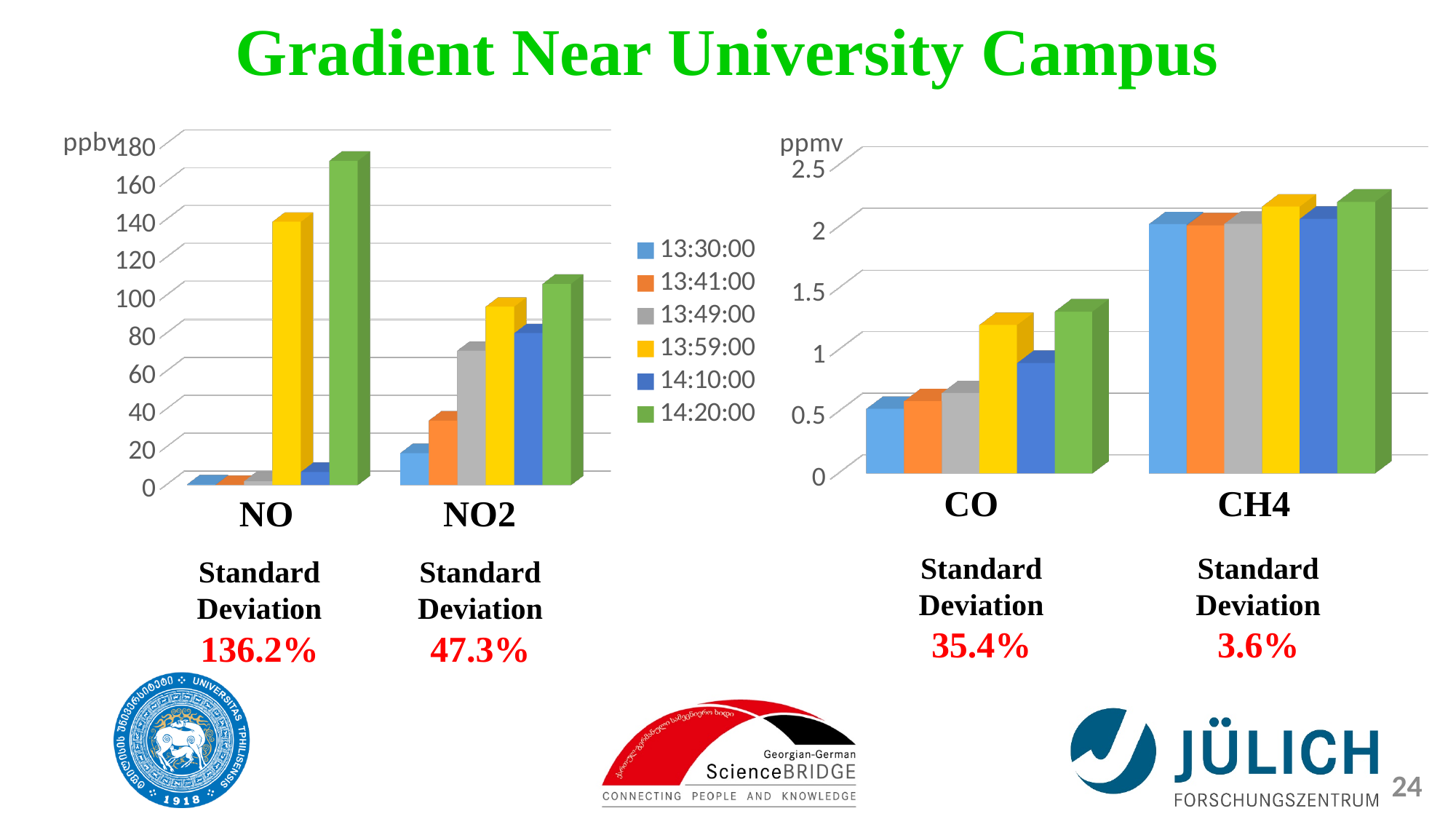
On the right chart (ppmv), which is larger for CO: the value at 13:59:00 or at 13:30:00? 13:59:00 What unit is shown on the y axis of the right chart? ppmv On the left chart (ppbv), which time has the highest value for NO? 14:20:00 On the left chart (ppbv), is the value for NO2 at 13:30:00 greater or less than 20? less On the left chart (ppbv), which time has the highest value for NO2? 14:20:00 How many series does the legend list? 6 On the right chart (ppmv), is the value for CO at 13:30:00 greater or less than 1? less On the left chart (ppbv), which is larger for NO2: the value at 13:41:00 or at 13:49:00? 13:49:00 How many categories are shown on the left chart (ppbv)? 2 On the left chart (ppbv), is the value for NO at 14:20:00 greater or less than 140? greater What kind of chart is the left chart (ppbv)? bar chart How many categories are shown on the right chart (ppmv)? 2